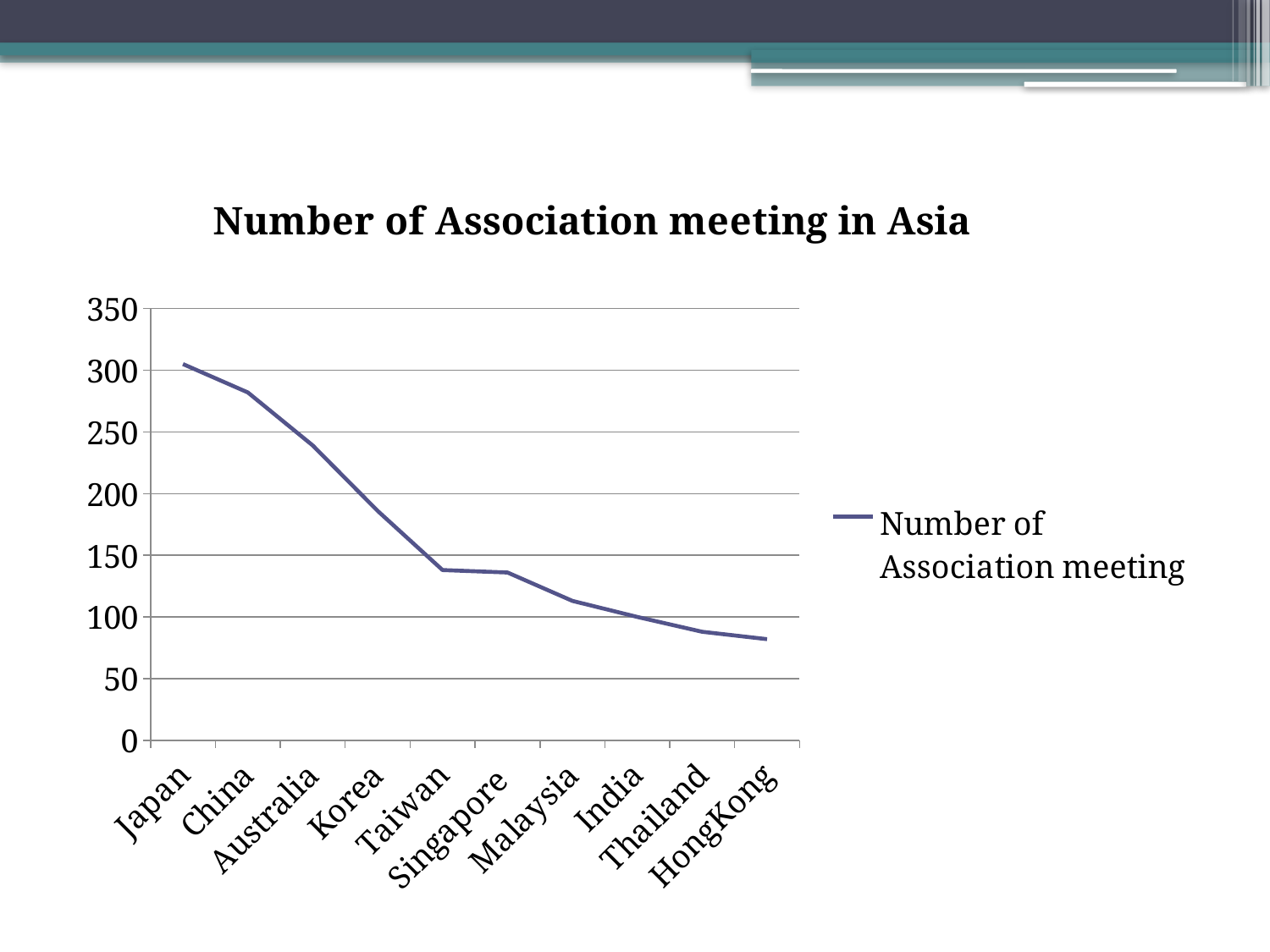
Which country has the highest number of association meetings? Japan Which has a larger value, Australia or Korea? Australia Which country has the lowest number of association meetings? HongKong Is the value for Thailand greater or less than 100? less How many countries are plotted along the x axis? 10 How many series does the legend list? 1 Do the values rise or fall moving from Japan to HongKong along the x axis? fall Is the value for Taiwan greater or less than 150? less Is the value for Japan greater or less than 250? greater What is the legend entry for the plotted line? Number of Association meeting What kind of chart is shown on the slide? line chart What is the title of the chart? Number of Association meeting in Asia